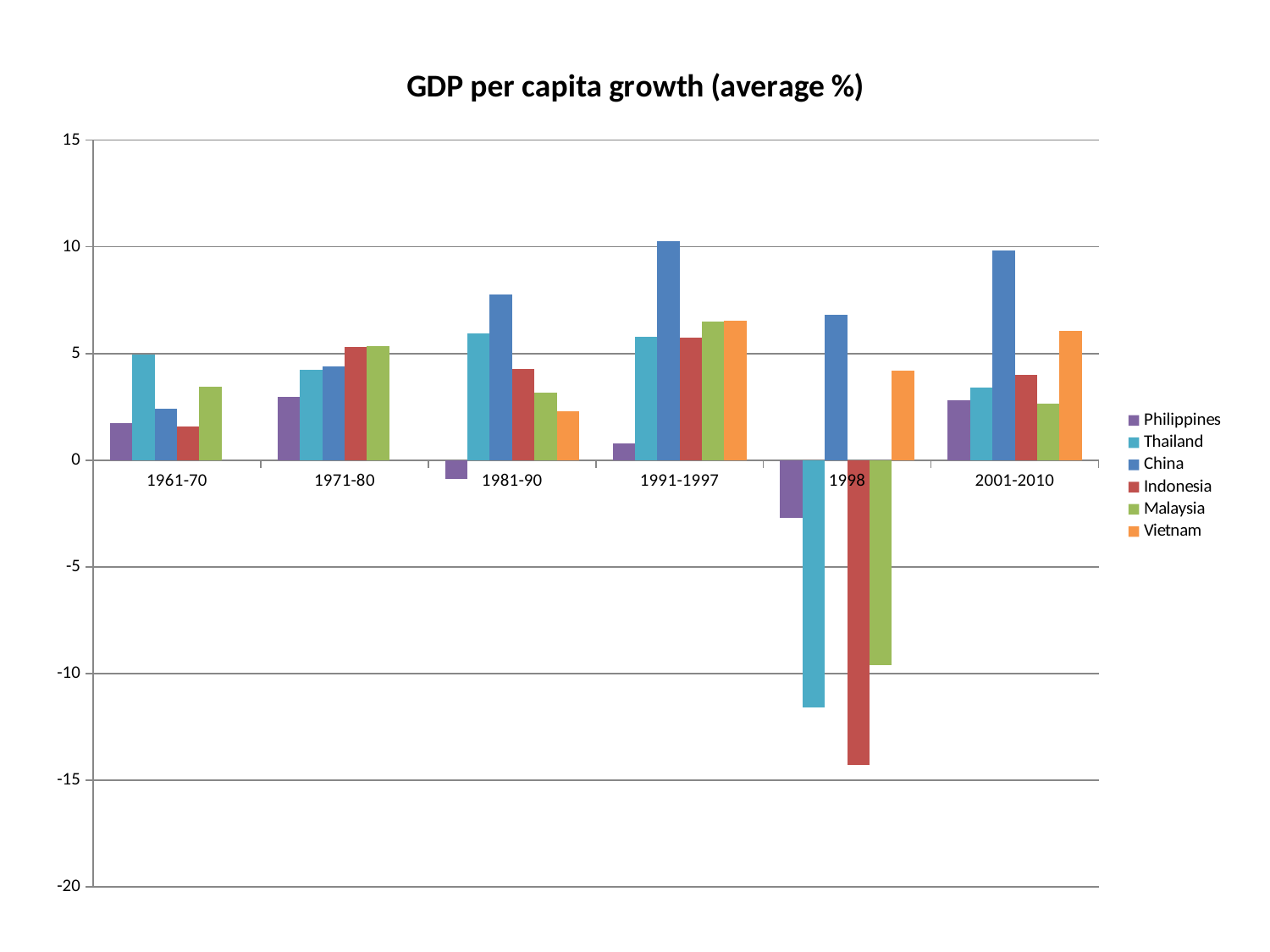
Is the value for Indonesia in 1998 greater or less than -10? less In 1998, which is larger: the value for China or the value for Vietnam? China How many time periods are shown on the x axis? 6 What kind of chart is shown on the slide? bar chart What is the title of the chart? GDP per capita growth (average %) Is the value for Vietnam in 2001-2010 greater or less than 5? greater Does the value for China rise or fall from 1961-70 to 1991-1997? rise Which country has the highest GDP per capita growth in 1961-70? Thailand How many series does the legend list? 6 Which country has the lowest GDP per capita growth in 1998? Indonesia Is the value for China in 2001-2010 greater or less than 5? greater Which country has the highest GDP per capita growth in 1991-1997? China